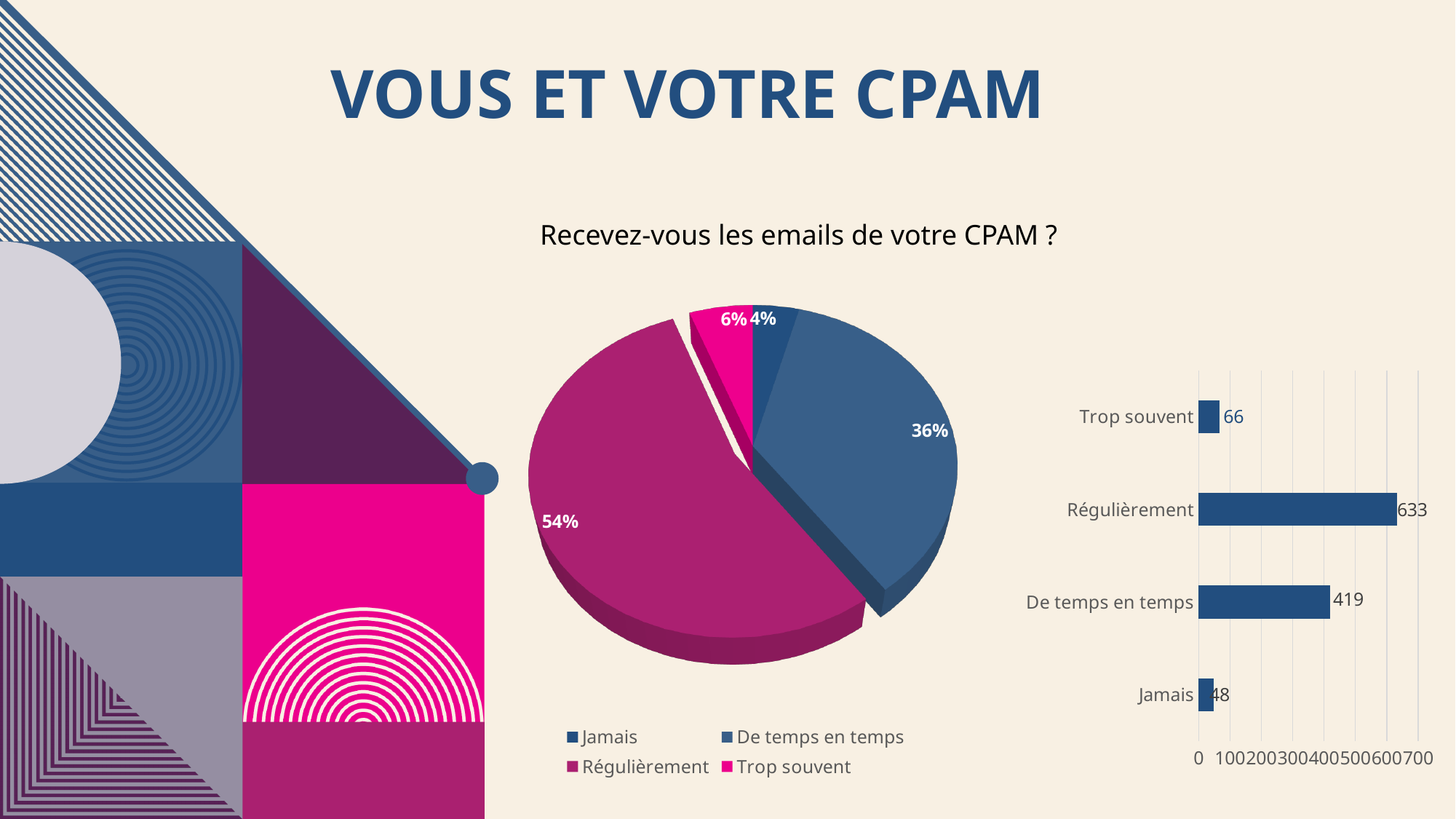
In the bar chart on the right of the slide, what is the difference between "Trop souvent" and "Jamais"? 18 In the pie chart titled "Recevez-vous les emails de votre CPAM ?", which category has the largest slice? Régulièrement What kind of chart is shown on the right of the slide? Bar chart In the pie chart titled "Recevez-vous les emails de votre CPAM ?", which category has the smallest slice? Jamais In the pie chart titled "Recevez-vous les emails de votre CPAM ?", what share does "Régulièrement" have? 54% In the bar chart on the right of the slide, which category has the lowest value? Jamais In the pie chart titled "Recevez-vous les emails de votre CPAM ?", what share does "De temps en temps" have? 36% In the bar chart on the right of the slide, what is the value for "Jamais"? 48 How many slices does the pie chart titled "Recevez-vous les emails de votre CPAM ?" have? 4 In the pie chart titled "Recevez-vous les emails de votre CPAM ?", what is the difference in percentage points between "Régulièrement" and "De temps en temps"? 18 In the bar chart on the right of the slide, what is the value for "De temps en temps"? 419 In the bar chart on the right of the slide, what is the value for "Régulièrement"? 633